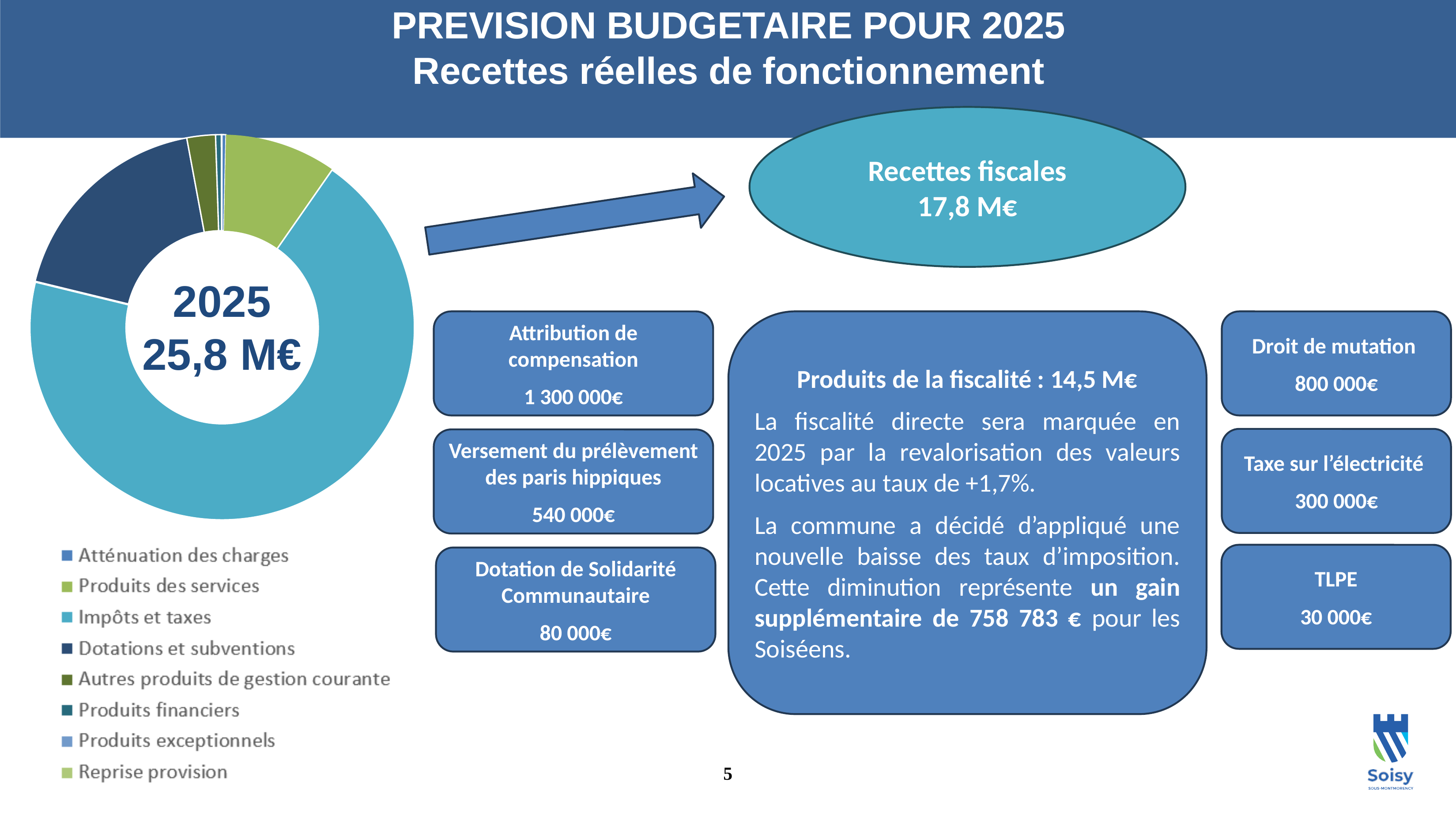
Which slice is larger in the pie chart: Produits des services or Autres produits de gestion courante? Produits des services Which year is printed in the centre of the pie chart? 2025 What is the last category listed in the pie chart's legend? Reprise provision Which category has the largest slice in the pie chart? Impôts et taxes How many categories does the legend of the pie chart list? 8 Which slice is larger in the pie chart: Impôts et taxes or Dotations et subventions? Impôts et taxes What total amount is printed in the centre of the pie chart? 25,8 M€ Which category has the second-largest slice in the pie chart? Dotations et subventions What kind of chart is shown on the slide? Pie chart (donut) Which slice is larger in the pie chart: Dotations et subventions or Produits des services? Dotations et subventions